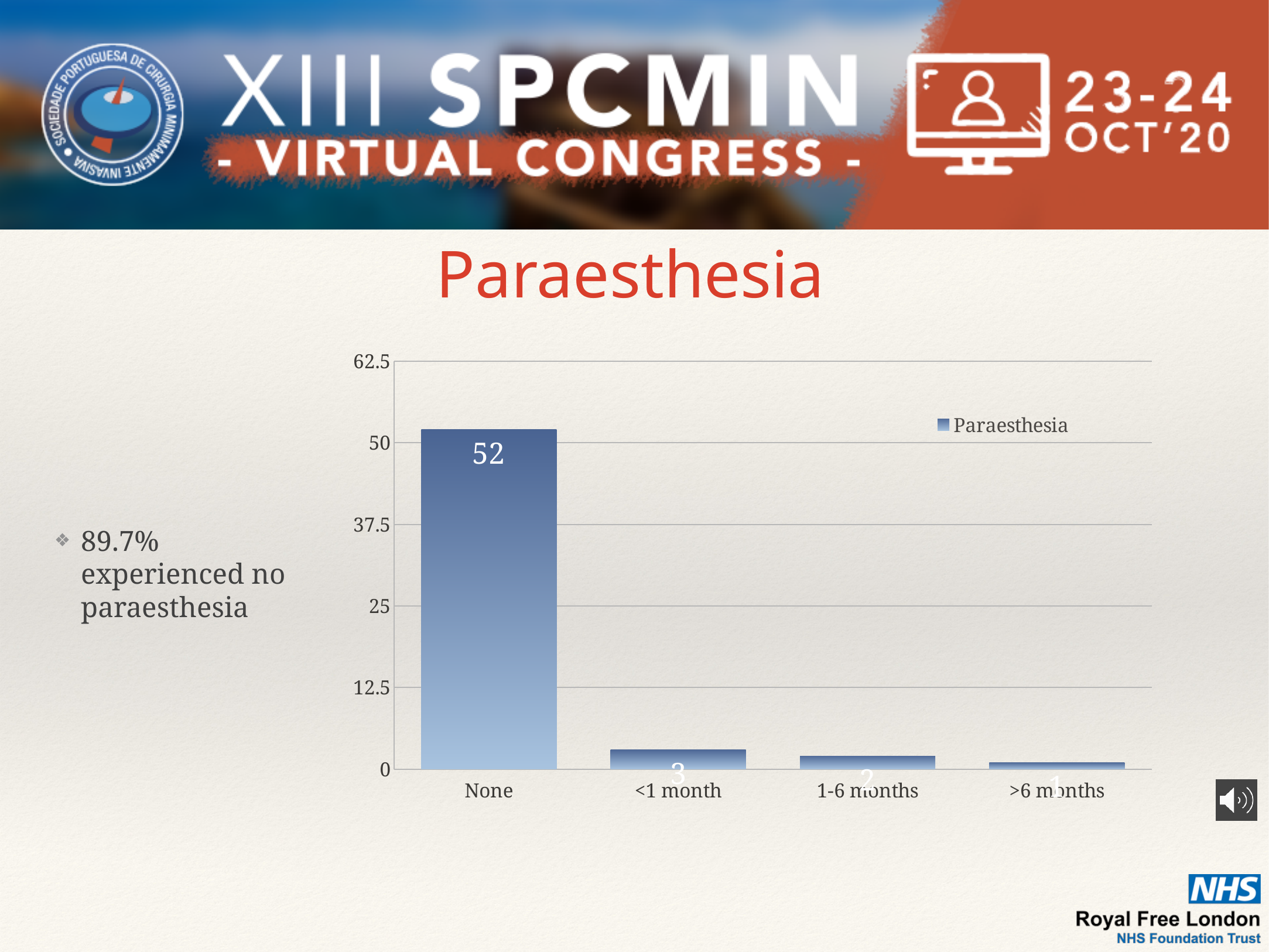
Which category has the highest value in the Paraesthesia chart? None What is the value for 1-6 months in the Paraesthesia chart? 2 Is the value for None greater or less than 50? greater How many series does the chart legend list? 1 How many categories are shown on the x axis of the chart? 4 Which is larger, the value for <1 month or the value for >6 months? <1 month Which category has the lowest value in the Paraesthesia chart? >6 months What is the difference between the values for None and <1 month? 49 What is the value for None in the Paraesthesia chart? 52 What is the value for >6 months in the Paraesthesia chart? 1 What kind of chart is shown on the slide? bar chart What is the value for <1 month in the Paraesthesia chart? 3